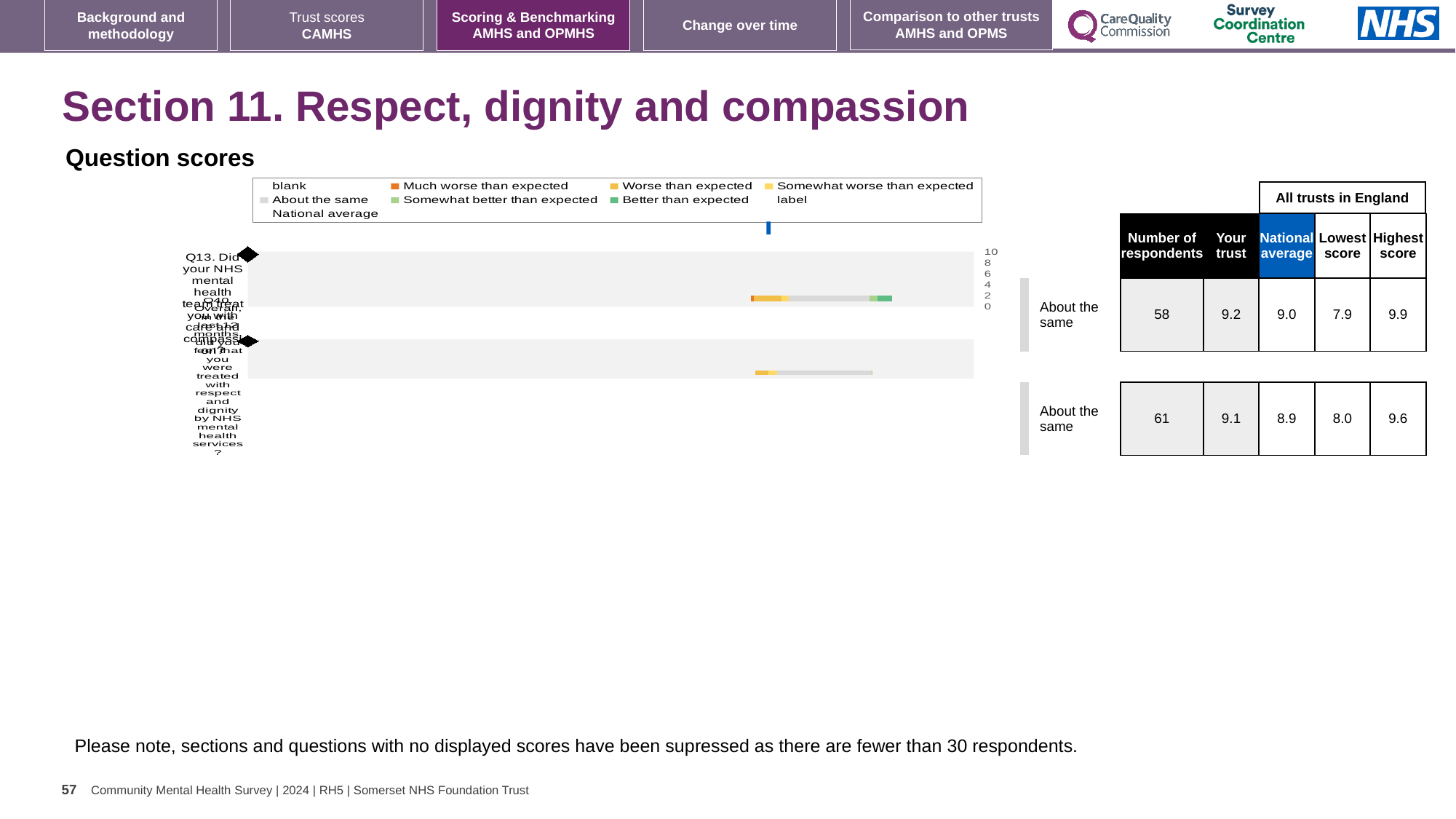
In the table beside the chart, what is the national average for the top row? 9.0 In the table beside the chart, what is the 'Your trust' score for the top row? 9.2 In the table beside the chart, what is the number of respondents for the bottom row? 61 In the table beside the chart, which row has the larger number of respondents, the top row or the bottom row? bottom row In the table beside the chart, what is the highest score across all trusts in England for the top row? 9.9 In the table beside the chart, what is the difference between the 'Your trust' score and the national average for the bottom row? 0.2 In the table beside the chart, what is the lowest score across all trusts in England for the bottom row? 8.0 In the table beside the chart, what is the 'Your trust' score for the bottom row? 9.1 How many question rows (bars) are plotted in the chart? 2 What kind of chart is shown under 'Question scores'? bar chart Which legend entry is shown in dark orange? Much worse than expected What is the highest value shown on the chart's numeric axis? 10